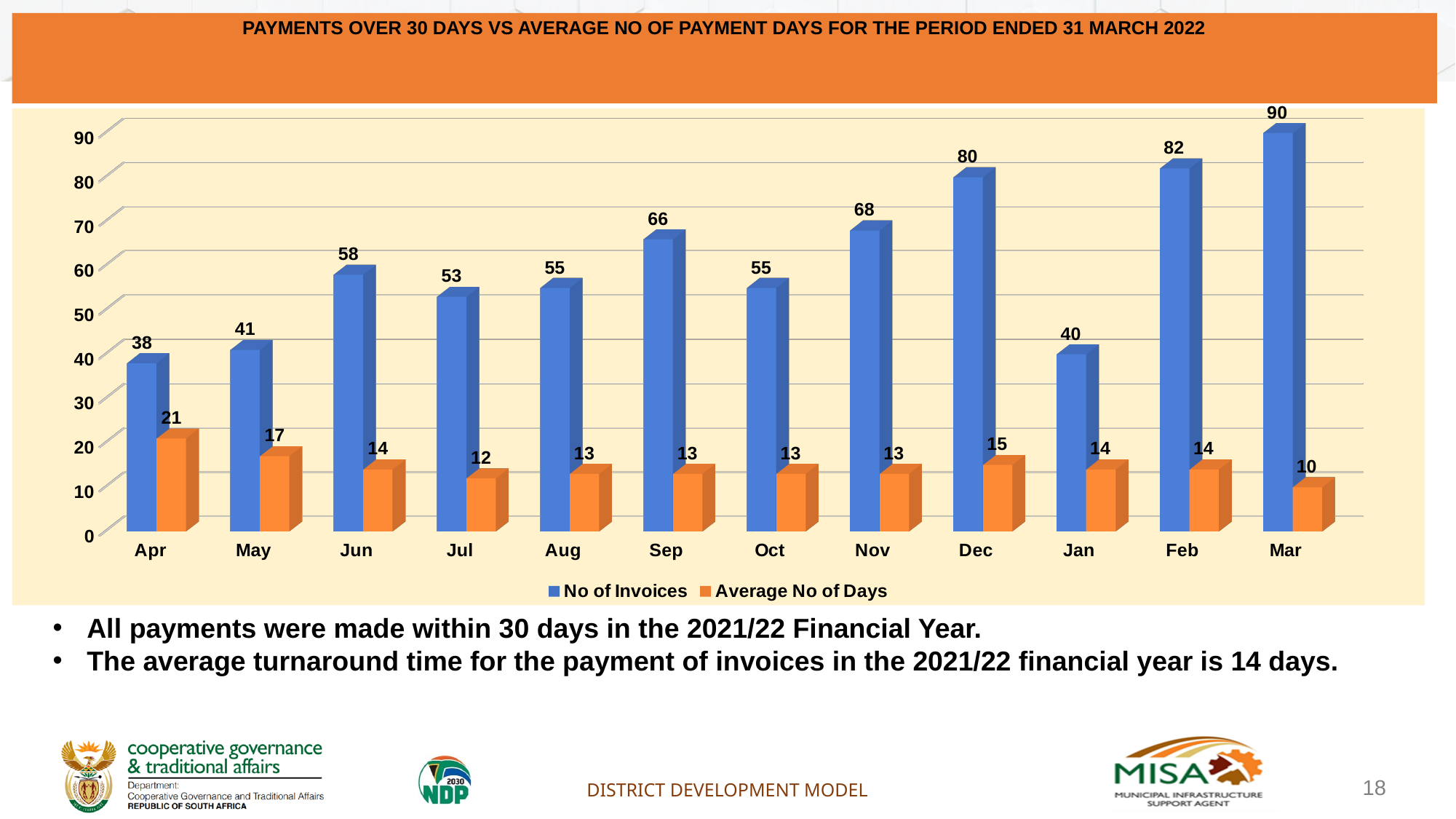
Which is larger, the No of Invoices for Jun or for Jul? Jun What is the difference between the Average No of Days for Apr and for Dec? 6 Which colour represents the Average No of Days series in the legend? Orange How many series does the legend list? 2 What is the No of Invoices value for Sep? 66 Which month has the lowest No of Invoices? Apr How many months are shown on the x axis? 12 What is the Average No of Days value for Apr? 21 Which month has the highest No of Invoices? Mar Which month has the lowest Average No of Days? Mar What is the difference between the No of Invoices for Mar and for Jan? 50 What kind of chart is shown on the slide? Bar chart